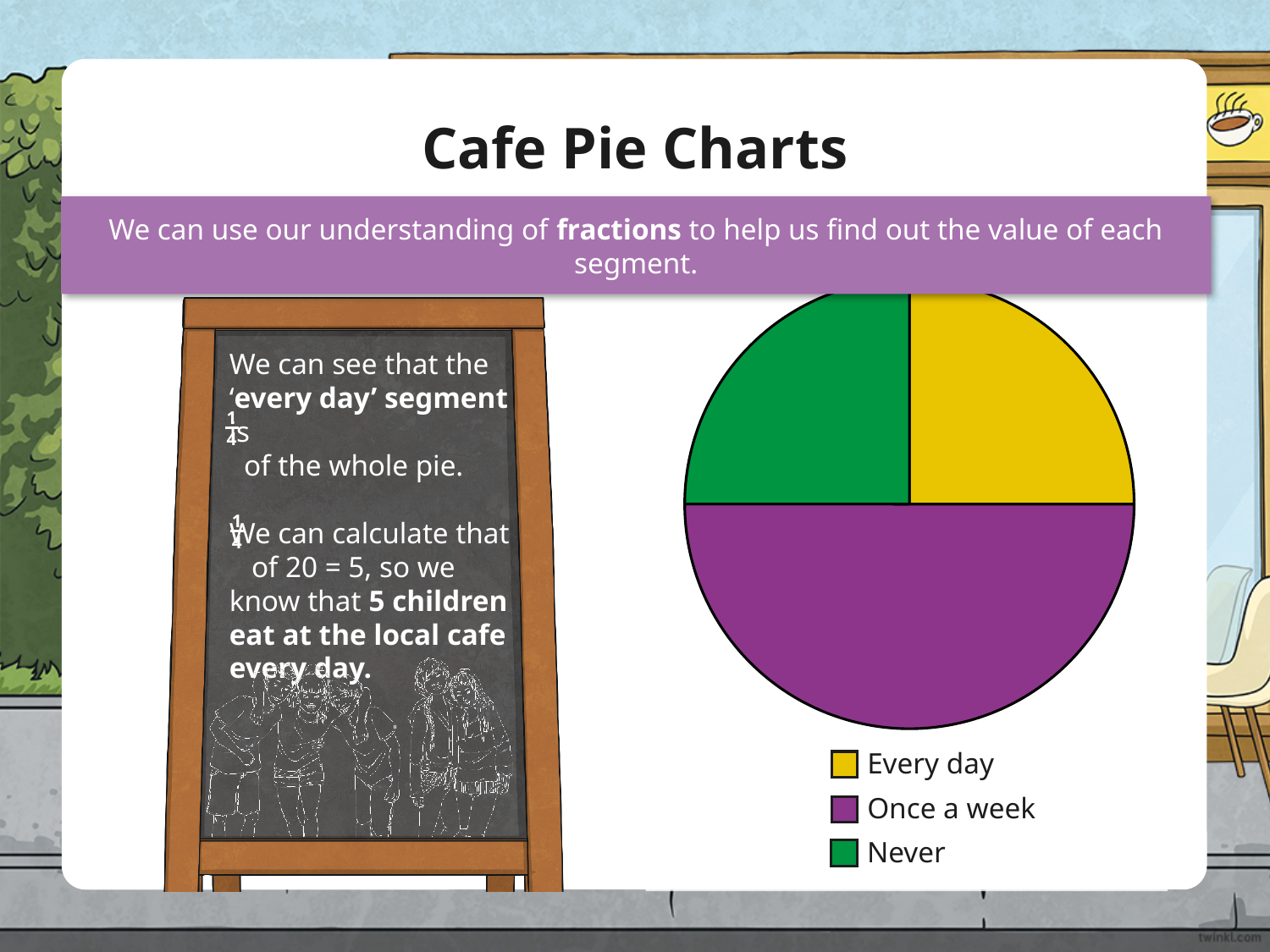
What kind of chart is shown on the slide? pie chart Which category is shown in green in the pie chart? Never How many entries does the legend of the pie chart list? 3 What colour is the 'Once a week' segment in the pie chart? purple According to the slide, how many children eat at the local cafe every day? 5 Which category has the largest segment in the pie chart? Once a week How many segments does the pie chart have? 3 Which segment is larger in the pie chart, 'Once a week' or 'Never'? Once a week Which segment is larger in the pie chart, 'Once a week' or 'Every day'? Once a week What fraction of the whole pie is the 'Every day' segment? 1/4